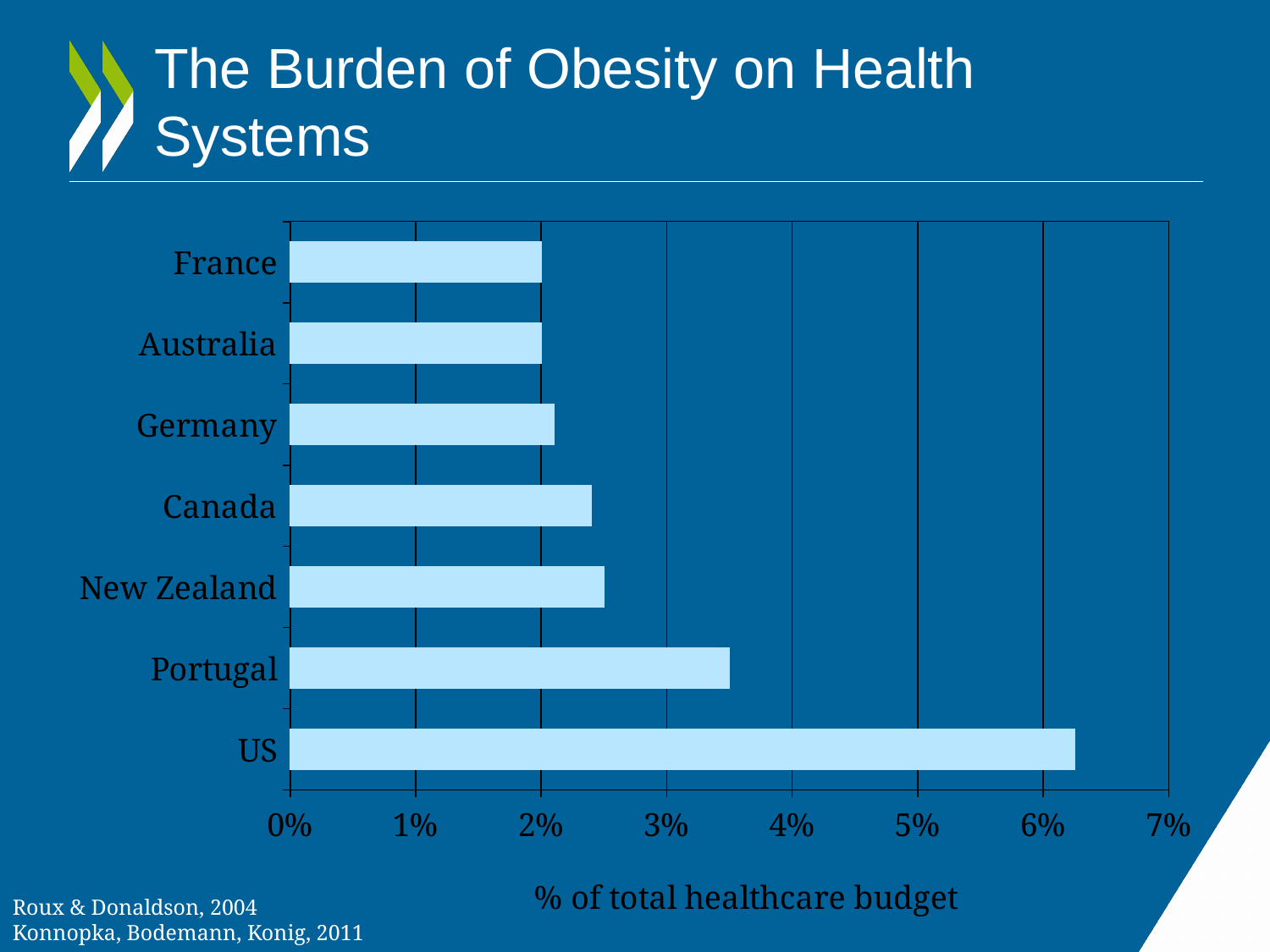
Is the value for Canada greater or less than 2%? greater How many countries are shown in the chart? 7 Which country has the highest share of total healthcare budget attributed to obesity? US Is the value for the US greater or less than 6%? greater What kind of chart is shown on the slide? bar chart Which has a larger value, Portugal or Canada? Portugal Which has a larger value, the US or Portugal? US Is the value for New Zealand greater or less than 3%? less What is the label of the horizontal axis? % of total healthcare budget What is the title of the slide containing the chart? The Burden of Obesity on Health Systems